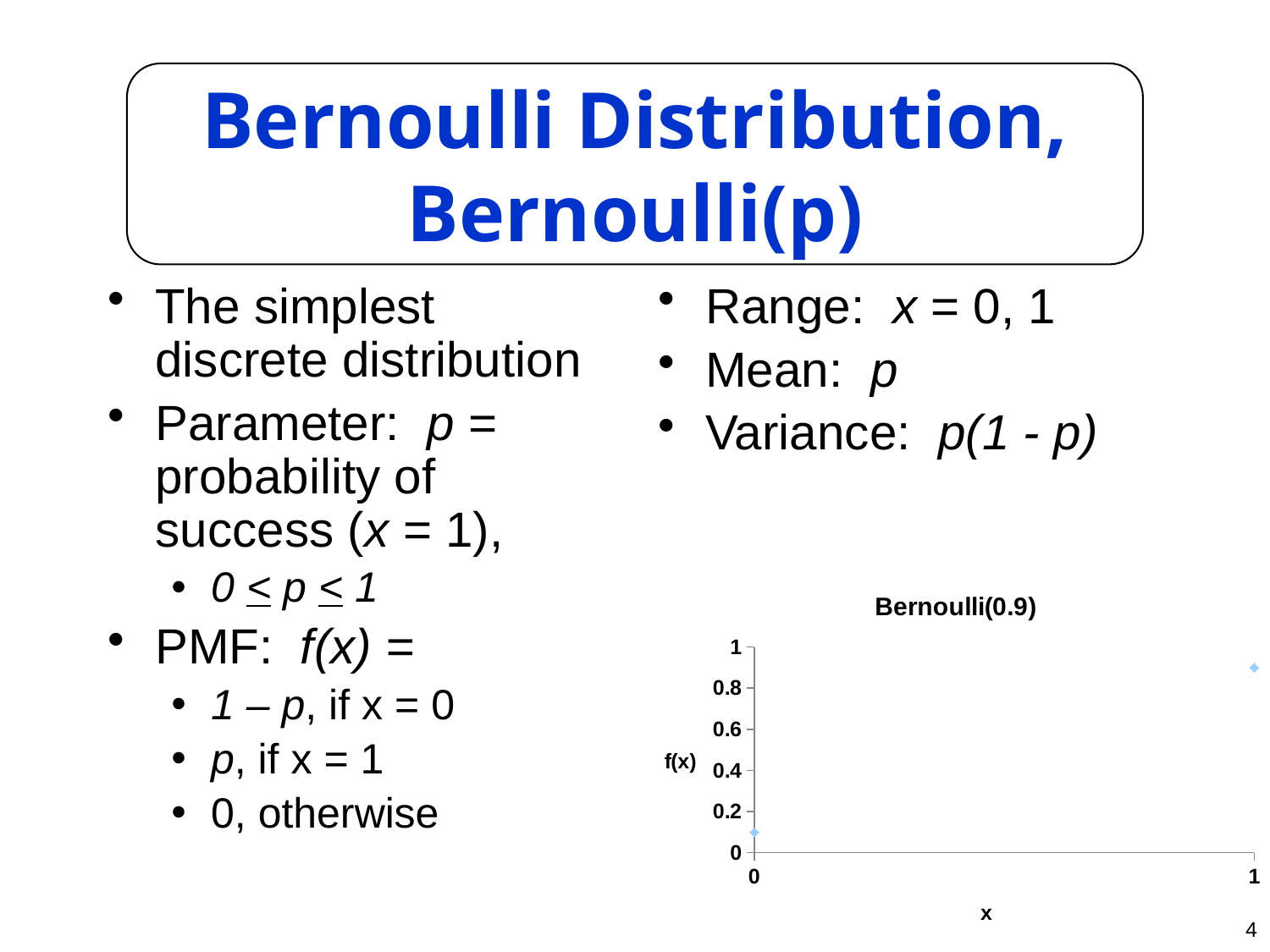
In the Bernoulli(0.9) chart, is the value of f(x) at x = 0 greater or less than 0.4? less How many data points are plotted in the Bernoulli(0.9) chart? 2 In the Bernoulli(0.9) chart, is the value of f(x) at x = 0 greater or less than 0.2? less In the Bernoulli(0.9) chart, does f(x) rise or fall as x goes from 0 to 1? rise What kind of chart is shown on the slide? scatter chart In the Bernoulli(0.9) chart, which x value has the higher f(x)? 1 In the Bernoulli(0.9) chart, is the value of f(x) at x = 1 greater or less than 0.6? greater What is the label of the vertical axis in the Bernoulli(0.9) chart? f(x) What is the title of the chart on the slide? Bernoulli(0.9) In the Bernoulli(0.9) chart, is f(x) larger at x = 0 or at x = 1? x = 1 In the Bernoulli(0.9) chart, which x value has the lower f(x)? 0